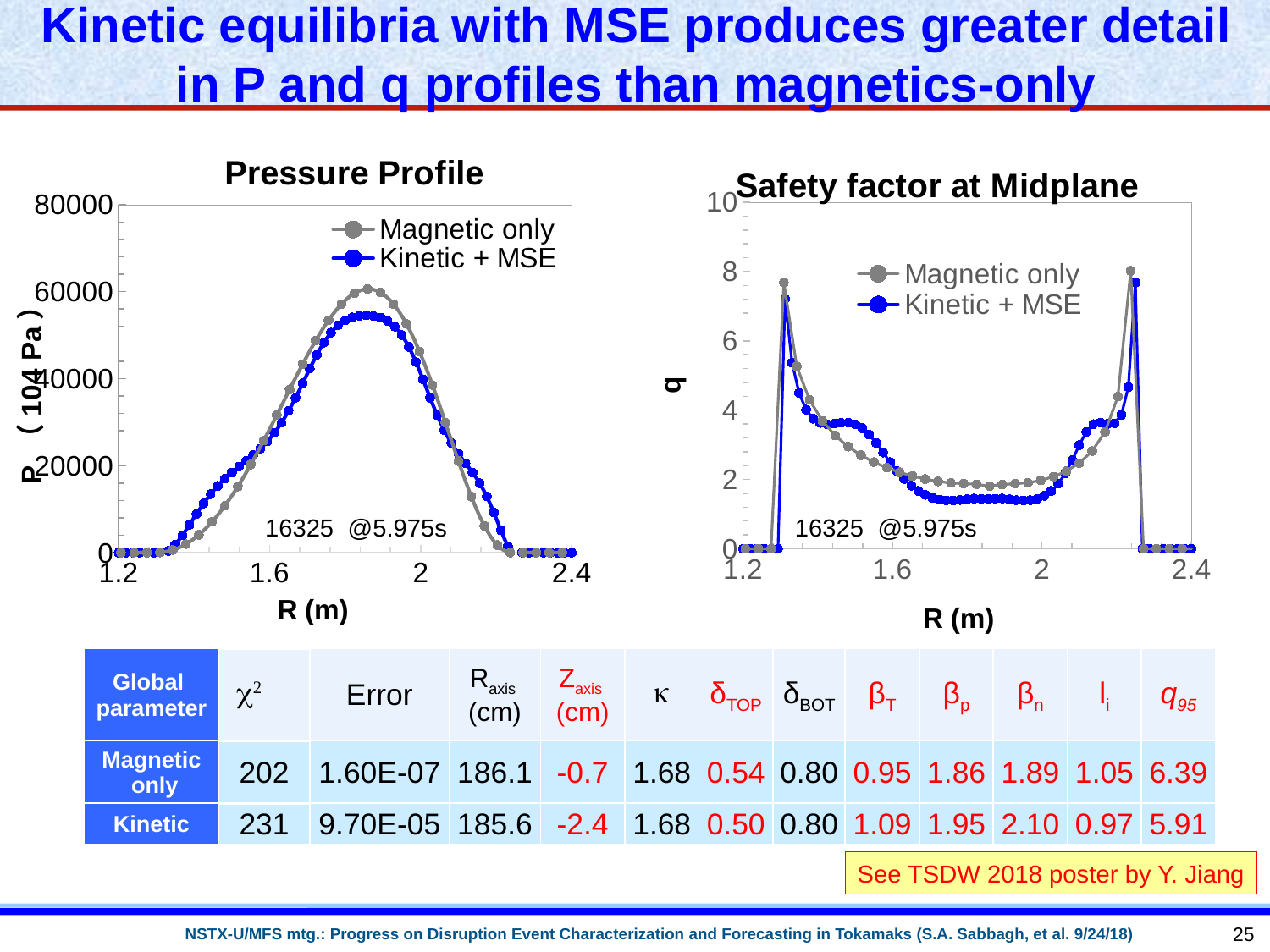
In the Pressure Profile chart, does the Magnetic only series rise or fall between R = 1.6 m and R = 1.8 m? rise In the Safety factor at Midplane chart, at R = 1.8 m, which series has the higher q value, Magnetic only or Kinetic + MSE? Magnetic only In the Pressure Profile chart, is the peak value of the Kinetic + MSE series greater or less than 40000? greater In the Safety factor at Midplane chart, is the value of the Magnetic only series at R = 1.6 m greater or less than 4? less In the Pressure Profile chart, is the peak value of the Kinetic + MSE series greater or less than 60000? less What kind of chart is the Pressure Profile chart? line chart What are the two series named in the legend of the Pressure Profile chart? Magnetic only and Kinetic + MSE In the Pressure Profile chart, at R = 1.5 m, which series has the higher pressure, Magnetic only or Kinetic + MSE? Kinetic + MSE How many series does the legend of the Safety factor at Midplane chart list? 2 In the Pressure Profile chart, what is the label of the x axis? R (m) In the Safety factor at Midplane chart, does the Kinetic + MSE series rise or fall between R = 2.0 m and R = 2.2 m? rise